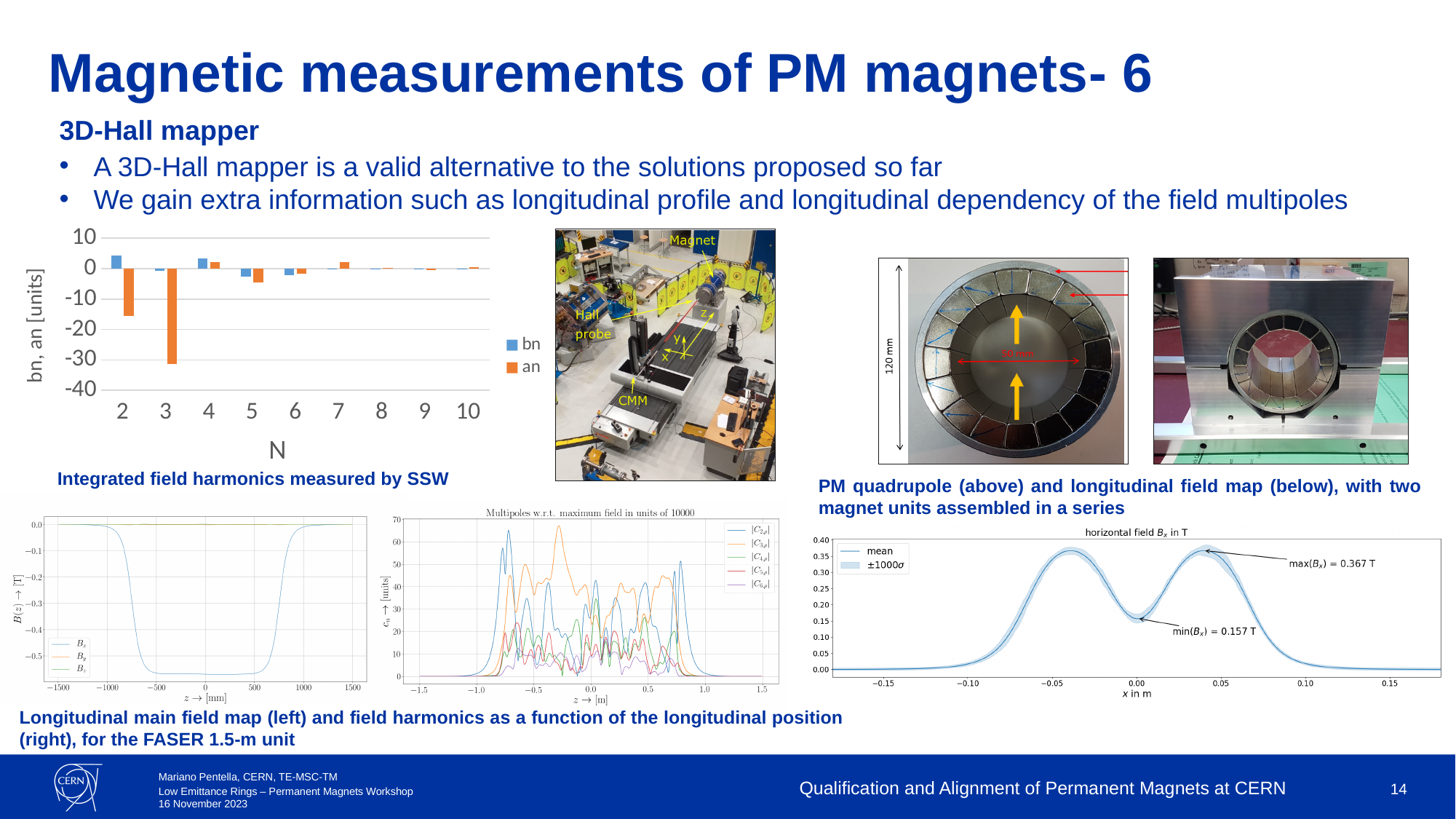
In the 'Integrated field harmonics measured by SSW' bar chart, is the an value at N=2 greater or less than -10? less In the 'Integrated field harmonics measured by SSW' bar chart, how many series does the legend list? 2 In the 'Integrated field harmonics measured by SSW' bar chart, is the an value at N=3 greater or less than -20? less In the 'Integrated field harmonics measured by SSW' bar chart, how many values of N are shown on the x axis? 9 In the 'Integrated field harmonics measured by SSW' bar chart, which has the lower value: an at N=2 or an at N=3? an at N=3 What kind of chart is the 'Integrated field harmonics measured by SSW' chart at the top left? bar chart In the 'Multipoles w.r.t. maximum field in units of 10000' chart, how many series does the legend list? 5 In the 'horizontal field Bx in T' chart at the bottom right, what is the labelled min(Bx)? 0.157 T In the 'horizontal field Bx in T' chart at the bottom right, what is the difference between the labelled max(Bx) and min(Bx)? 0.210 T In the longitudinal main field map chart at the bottom left, which series drops to the lowest value? Bx In the 'horizontal field Bx in T' chart at the bottom right, what is the labelled max(Bx)? 0.367 T In the 'Integrated field harmonics measured by SSW' bar chart, at which N does the an series reach its lowest value? 3